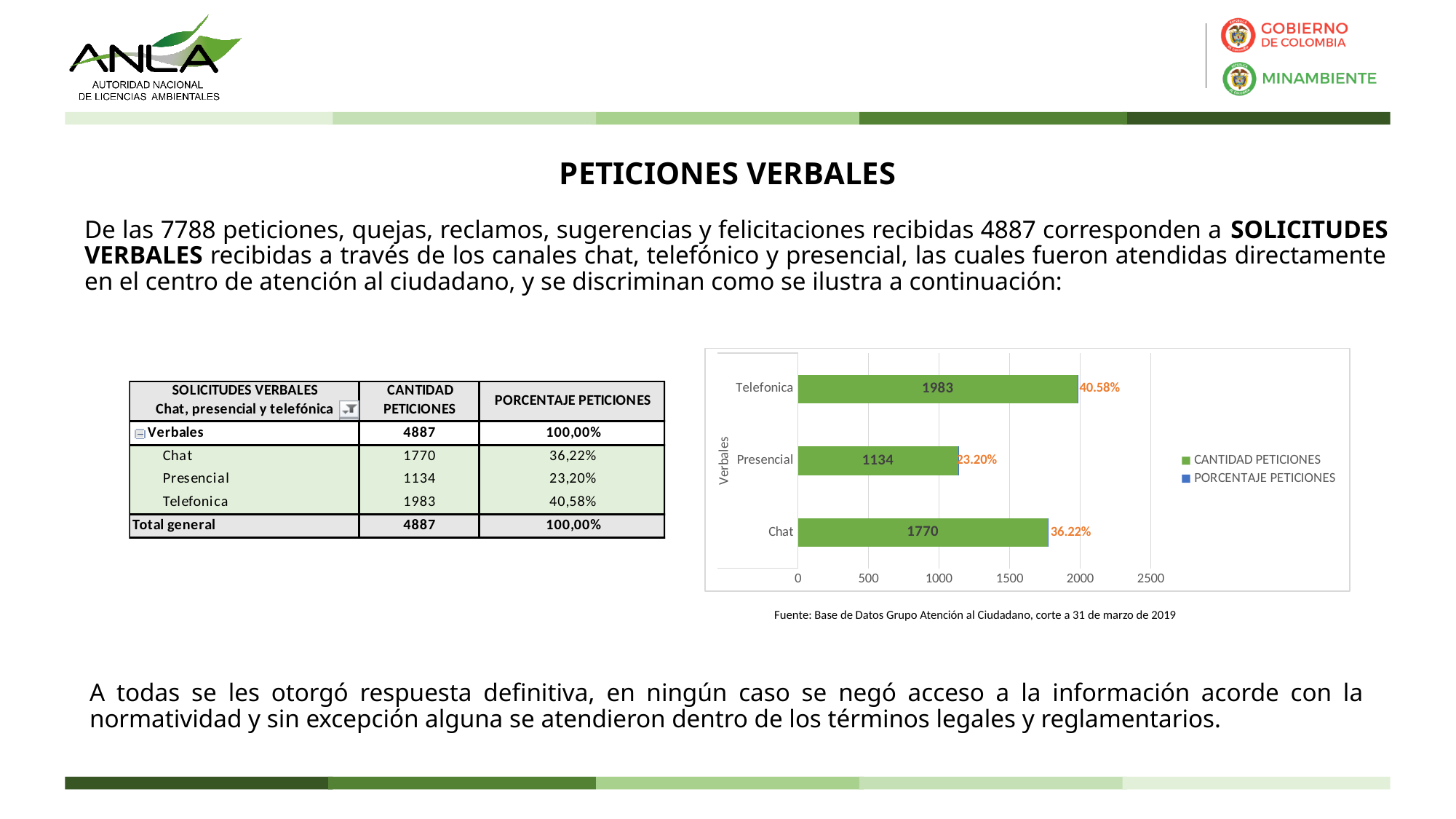
Which category has the lowest CANTIDAD PETICIONES in the chart? Presencial How many series does the chart legend list? 2 What kind of chart is shown on the slide? bar chart Is the CANTIDAD PETICIONES value for Presencial greater or less than 1500? less Which has more CANTIDAD PETICIONES, Chat or Presencial? Chat What is the CANTIDAD PETICIONES value for Telefonica in the chart? 1983 What is the label of the vertical axis of the chart? Verbales Which category has the highest CANTIDAD PETICIONES in the chart? Telefonica What percentage label is shown next to the Chat bar in the chart? 36.22% What is the difference in CANTIDAD PETICIONES between Telefonica and Chat? 213 How many categories are shown on the vertical axis of the chart? 3 What is the CANTIDAD PETICIONES value for Presencial in the chart? 1134